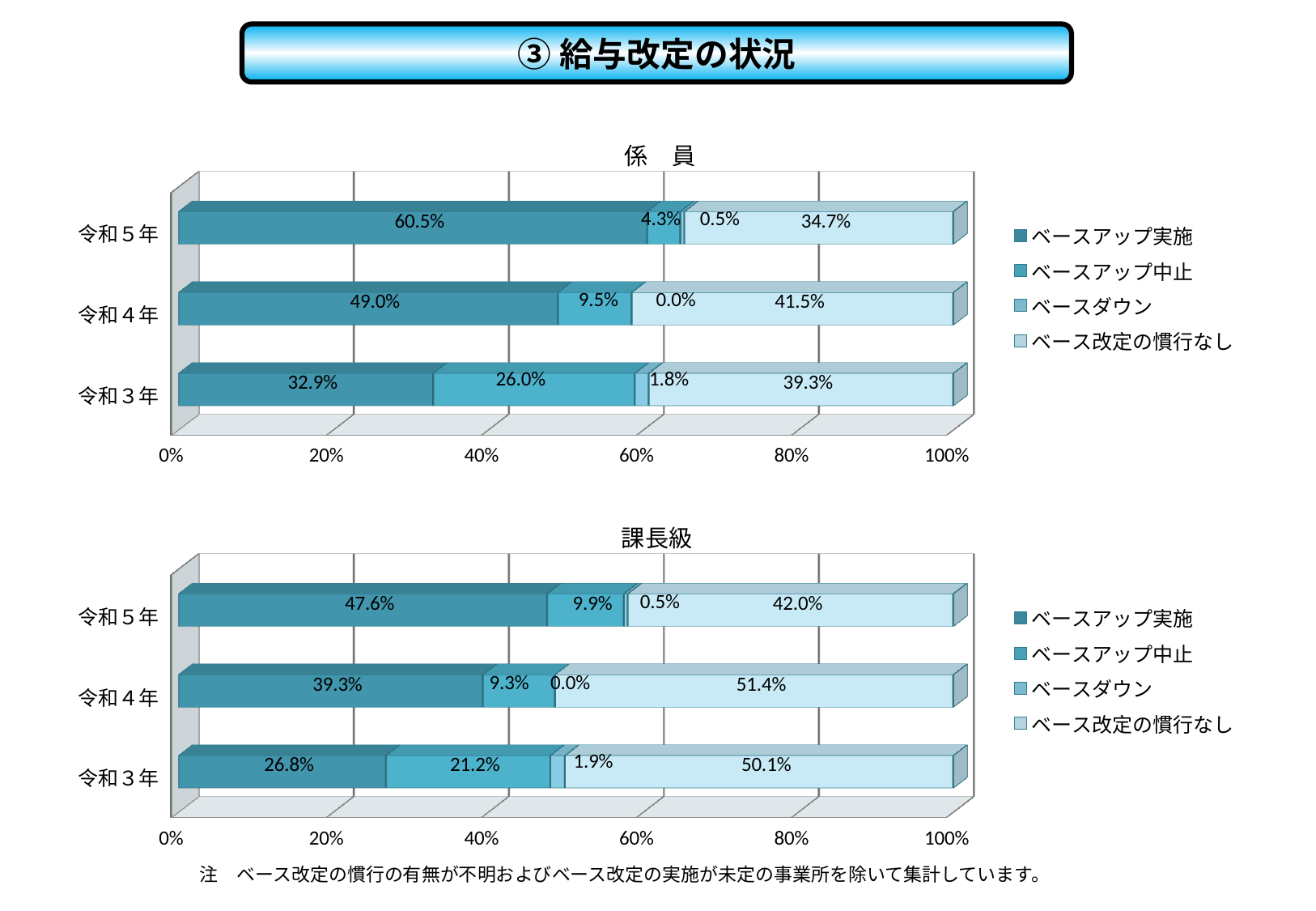
In the 課長級 chart, what is the value of ベース改定の慣行なし for 令和４年? 51.4% In the 課長級 chart, which is larger for 令和５年: ベースアップ実施 or ベース改定の慣行なし? ベースアップ実施 In the 係員 chart, what is the difference between the ベースアップ実施 values for 令和５年 and 令和４年? 11.5% In the 課長級 chart, which year has the lowest value for ベースアップ実施? 令和３年 In the 課長級 chart, how many series does the legend list? 4 What type of chart is the 係員 chart? Stacked bar chart In the 課長級 chart, does the value of ベースアップ実施 rise or fall from 令和３年 to 令和５年? Rise In the 係員 chart, how many years are shown on the vertical axis? 3 In the 係員 chart, which year has the highest value for ベースアップ実施? 令和５年 In the 係員 chart, what is the value of ベースアップ中止 for 令和３年? 26.0% In the 係員 chart, what is the value of ベースアップ実施 for 令和５年? 60.5% In the 課長級 chart, what is the value of ベースダウン for 令和３年? 1.9%